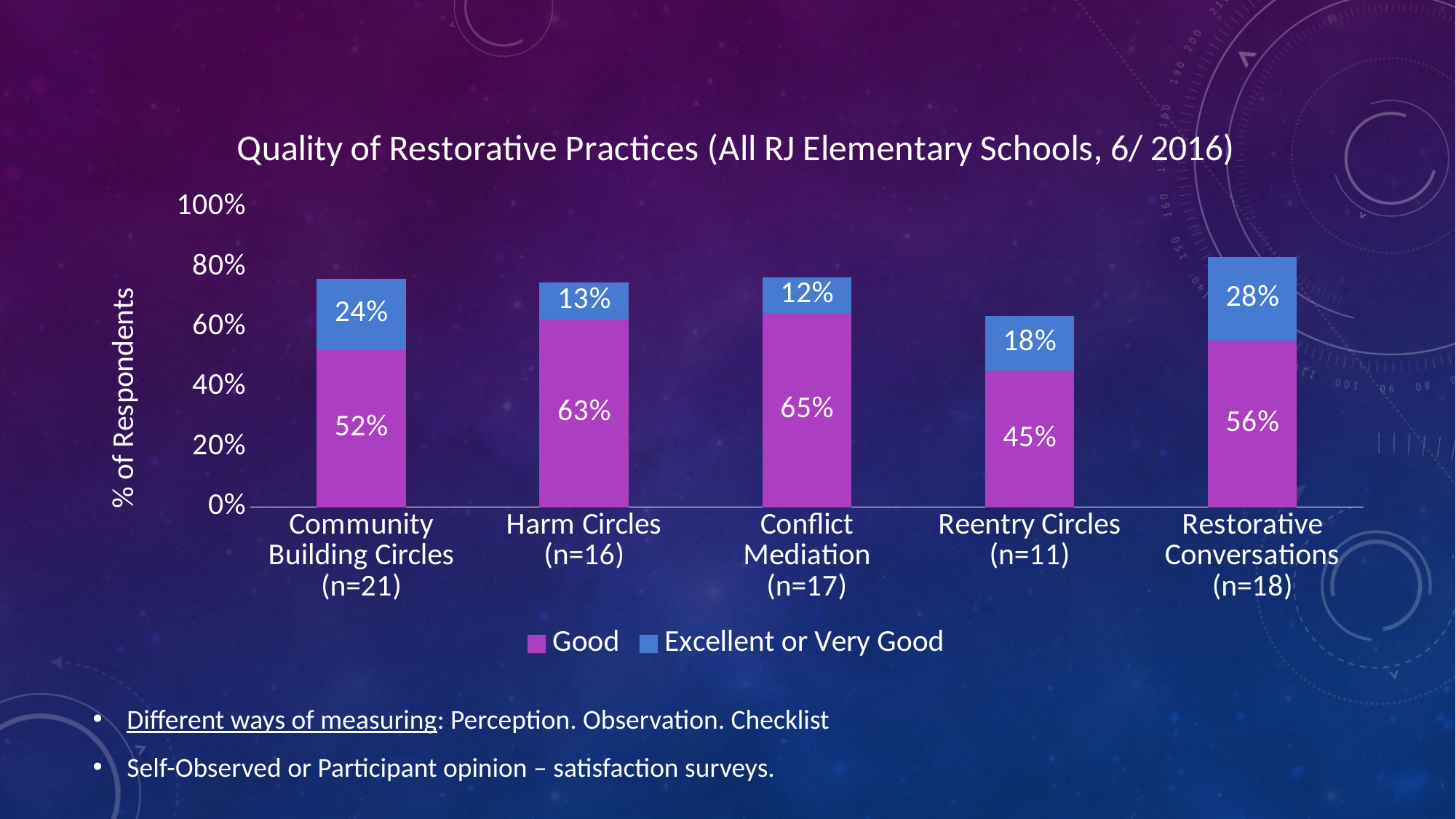
What percentage of respondents rated Restorative Conversations (n=18) as Excellent or Very Good? 28% What is the Good value for Reentry Circles (n=11)? 45% Which category has the highest Good percentage? Conflict Mediation (n=17) How many series does the legend list? 2 Which category has the lowest Excellent or Very Good percentage? Conflict Mediation (n=17) What is the difference between the Good percentages for Harm Circles (n=16) and Reentry Circles (n=11)? 18% Which category has the lowest combined (stacked) total? Reentry Circles (n=11) What is the combined total of Good and Excellent or Very Good for Restorative Conversations (n=18)? 84% Which is larger: the Excellent or Very Good value for Community Building Circles (n=21) or for Reentry Circles (n=11)? Community Building Circles (n=21) What percentage of respondents rated Community Building Circles (n=21) as Good? 52% How many categories are shown on the x axis? 5 What type of chart is shown on the slide? Stacked bar chart